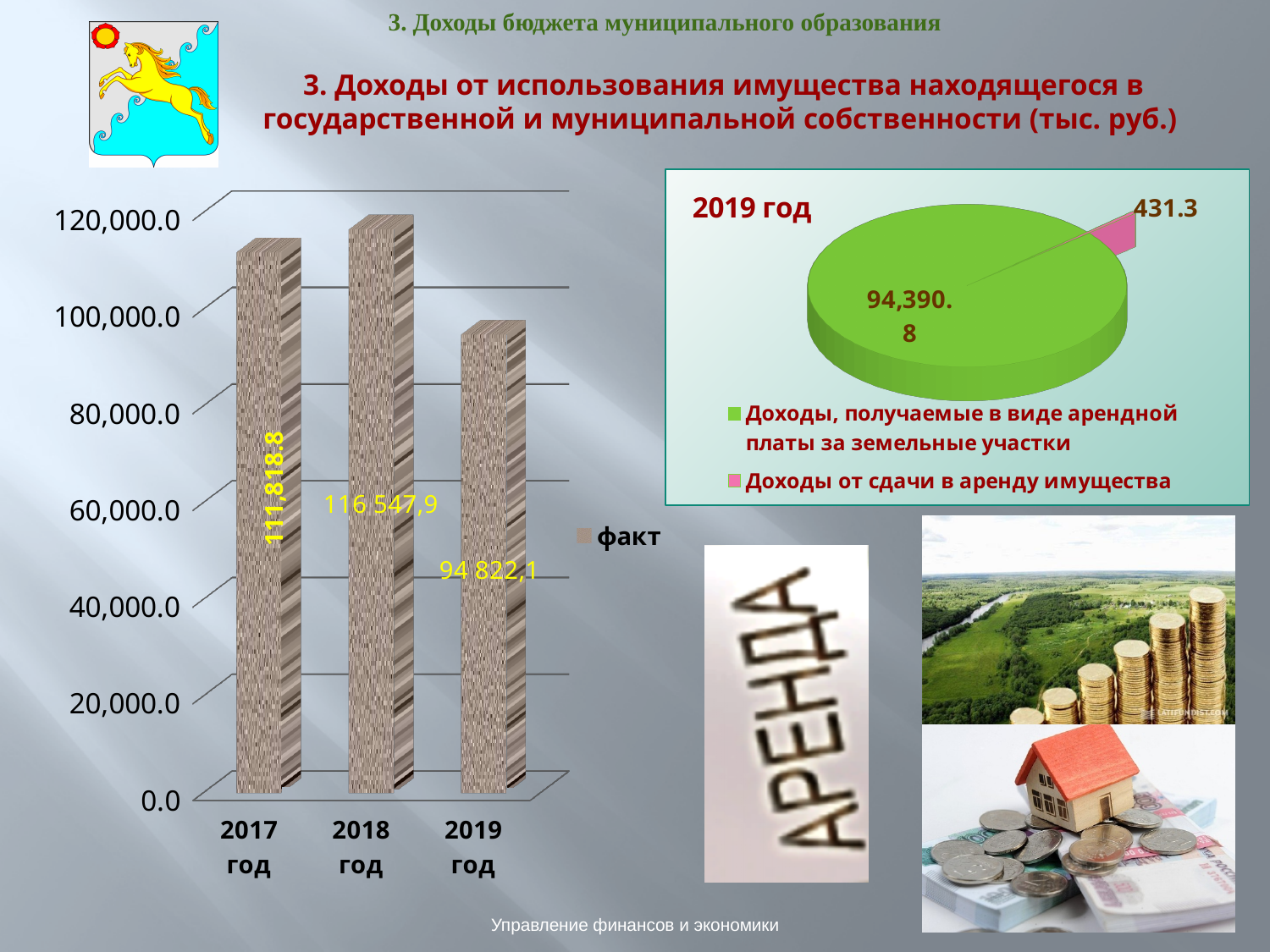
In the bar chart on the left, is the value for 2017 год greater or less than 100,000.0? greater In the bar chart on the left, what is the name of the series shown in the legend? факт In the bar chart on the left, how many years are shown on the x axis? 3 In the bar chart on the left, which year has the highest value? 2018 год In the bar chart on the left, what is the value for 2018 год? 116 547,9 In the bar chart on the left, which year has the lowest value? 2019 год In the pie chart titled 2019 год, which category has the larger slice? Доходы, получаемые в виде арендной платы за земельные участки In the bar chart on the left, which is larger: the value for 2017 год or the value for 2019 год? 2017 год What kind of chart is the chart on the left showing values for 2017, 2018 and 2019? bar chart In the pie chart titled 2019 год, how many categories does the legend list? 2 In the pie chart titled 2019 год, what is the value for Доходы от сдачи в аренду имущества? 431.3 In the bar chart on the left, what is the value for 2019 год? 94 822,1